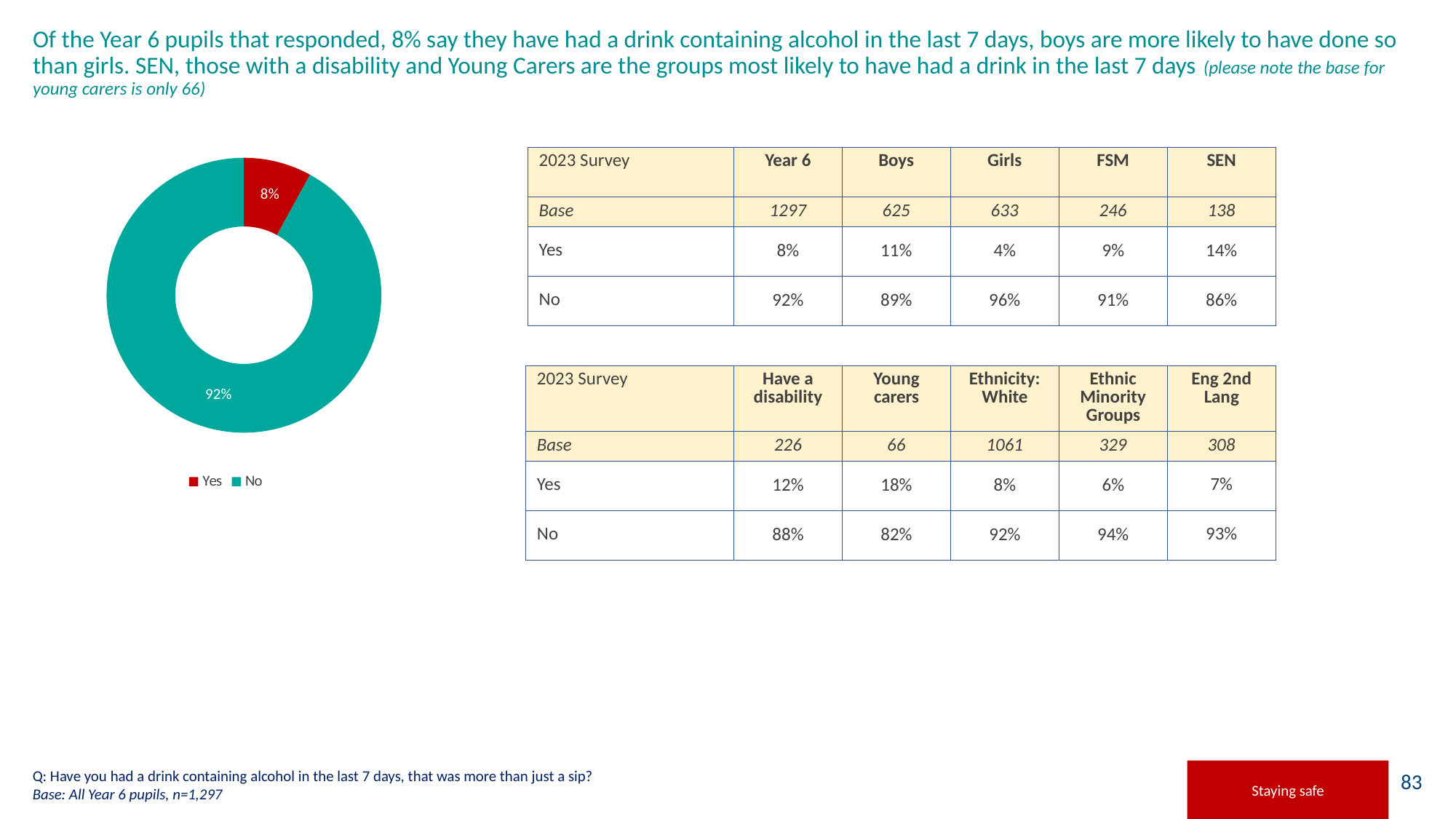
What percentage of the donut chart is labelled "No"? 92% How many entries does the legend of the donut chart list? 2 What is the difference in percentage points between the "No" and "Yes" slices of the donut chart? 84 In the donut chart, is the "Yes" slice larger or smaller than the "No" slice? smaller What colour is the "Yes" slice in the donut chart? Red Which slice of the donut chart is the smallest? Yes How many slices does the donut chart have? 2 What percentage of the donut chart is labelled "Yes"? 8% Which slice of the donut chart is the largest? No What share of the donut chart does the "No" slice represent? 92% What colour is the "No" slice in the donut chart? Teal What type of chart is shown on the left of the slide? Donut (pie) chart